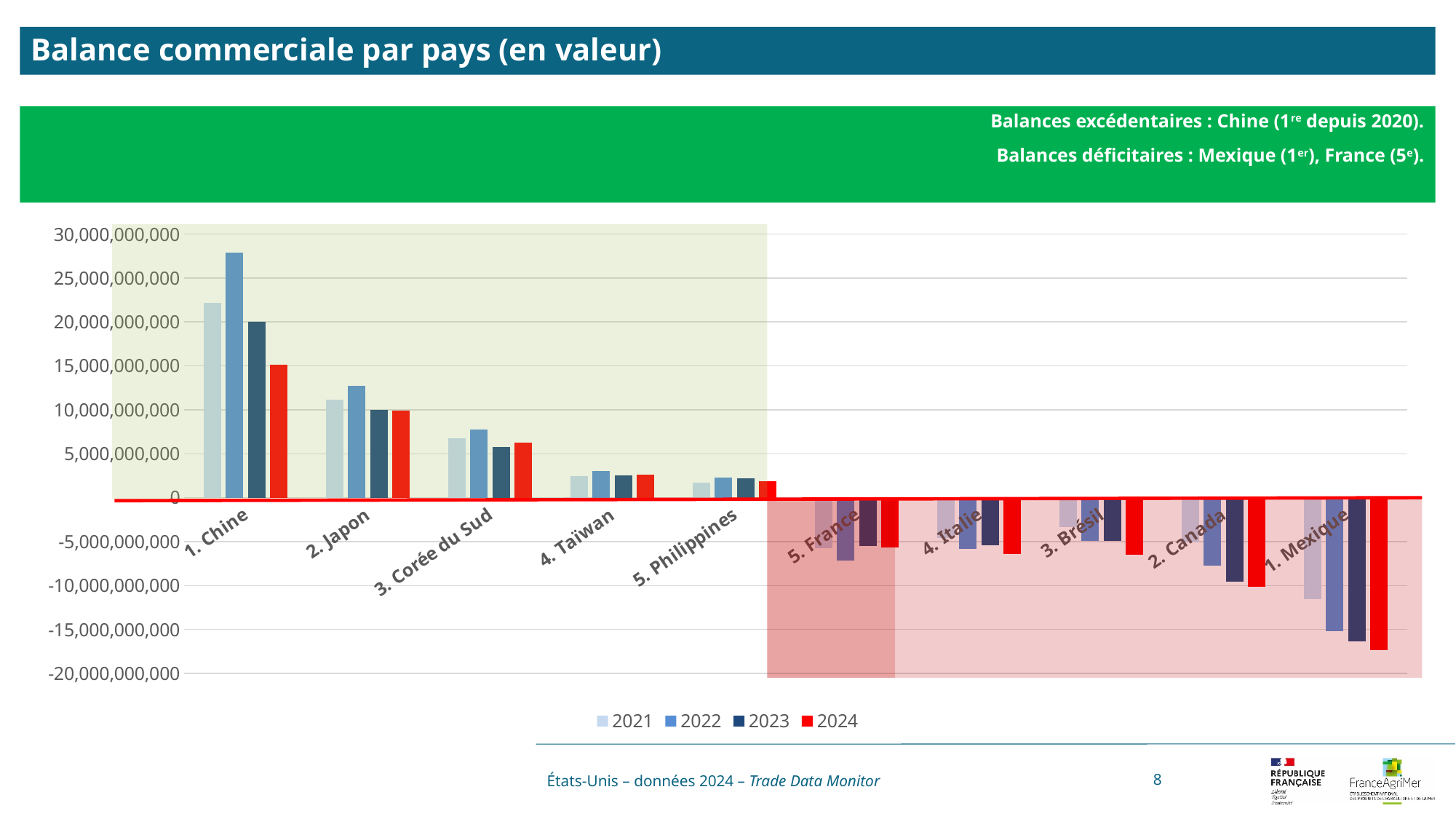
For 1. Mexique, do the values rise or fall from 2021 to 2024? fall Which country has the lowest (most negative) 2024 value in the chart? 1. Mexique Is the 2022 value for 1. Chine greater or less than 25,000,000,000? greater Which year's bar is the tallest for 1. Chine? 2022 Is the 2024 value for 1. Mexique greater or less than -15,000,000,000? less How many countries are shown on the x axis of the chart? 10 What is the title of the chart on the slide? Balance commerciale par pays (en valeur) Which country has the highest 2024 value in the chart? 1. Chine How many series does the legend list? 4 Is the 2024 value for 1. Chine greater or less than 10,000,000,000? greater Which is larger, the 2024 value for 1. Chine or the 2024 value for 2. Japon? 1. Chine What kind of chart is shown on the slide? bar chart